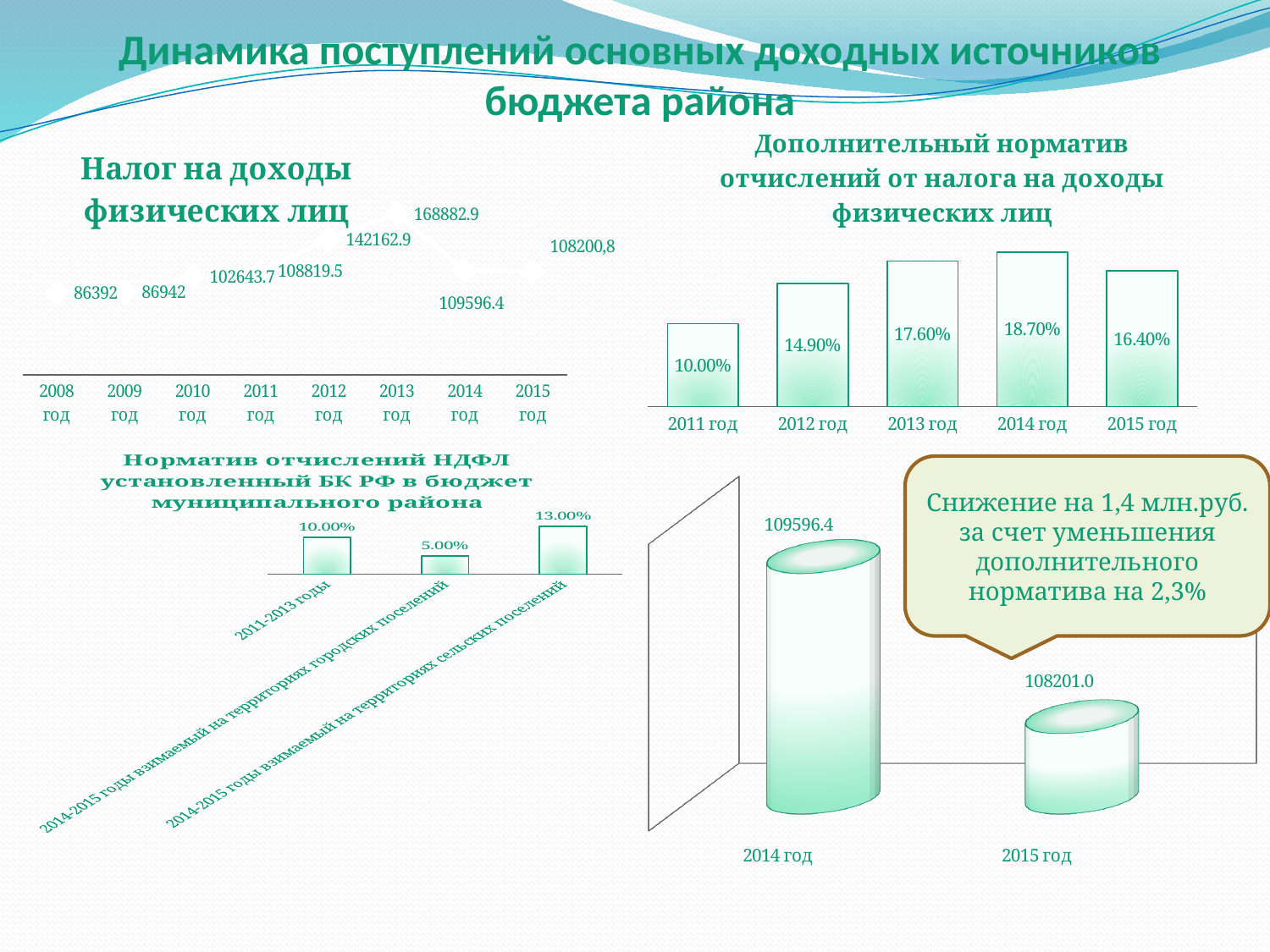
In the chart titled "Норматив отчислений НДФЛ установленный БК РФ в бюджет муниципального района", what is the value for 2011-2013 годы? 10.00% What kind of chart is the one titled "Дополнительный норматив отчислений от налога на доходы физических лиц"? bar chart In the chart titled "Налог на доходы физических лиц", what is the value for 2013 год? 168882.9 In the chart titled "Дополнительный норматив отчислений от налога на доходы физических лиц", which year has the highest value? 2014 год What kind of chart is the one titled "Налог на доходы физических лиц"? line chart In the chart titled "Норматив отчислений НДФЛ установленный БК РФ в бюджет муниципального района", how many categories are shown? 3 In the chart titled "Налог на доходы физических лиц", which year has the lowest value? 2008 год In the chart titled "Дополнительный норматив отчислений от налога на доходы физических лиц", what is the value for 2013 год? 17.60% In the chart titled "Дополнительный норматив отчислений от налога на доходы физических лиц", which is larger, the value for 2012 год or 2015 год? 2015 год In the chart titled "Налог на доходы физических лиц", how many years are shown on the x axis? 8 In the bottom-right chart, what is the value for 2015 год? 108201.0 In the chart titled "Налог на доходы физических лиц", which year has the highest value? 2013 год